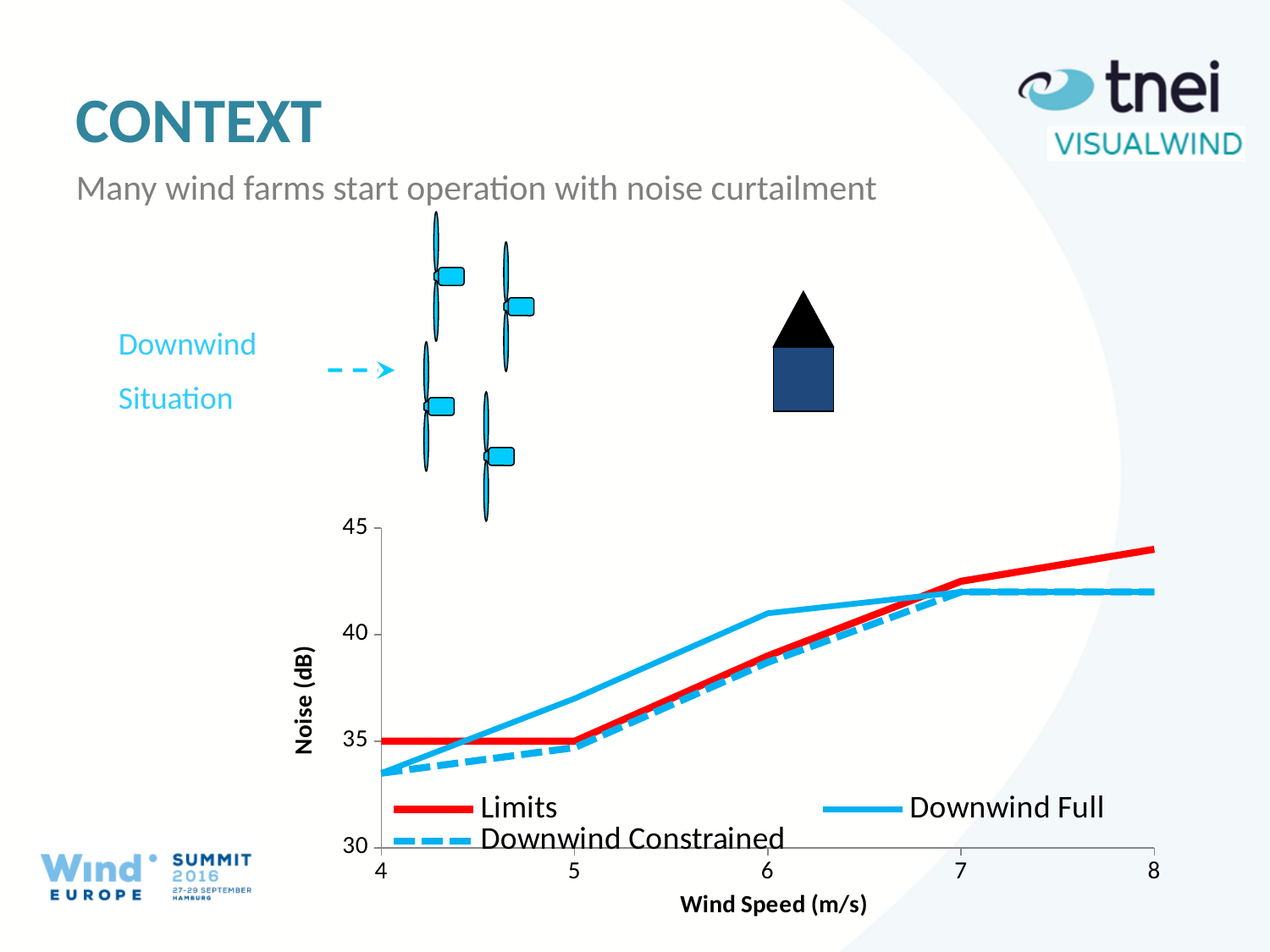
What is the label of the y axis of the chart? Noise (dB) What is the Limits value at a wind speed of 5 m/s? 35 Is the Downwind Full value at 4 m/s greater or less than 35? less How many wind speed values are marked on the x axis of the chart? 5 What is the Limits value at a wind speed of 4 m/s? 35 Is the Downwind Full value at 6 m/s greater or less than 40? greater What kind of chart is shown on the slide? line chart At a wind speed of 8 m/s, which is higher: Limits or Downwind Full? Limits At a wind speed of 6 m/s, which is higher: Downwind Full or Limits? Downwind Full Is the Limits value at 8 m/s greater or less than 40? greater How many series does the chart legend list? 3 Which series has the highest value at a wind speed of 8 m/s? Limits